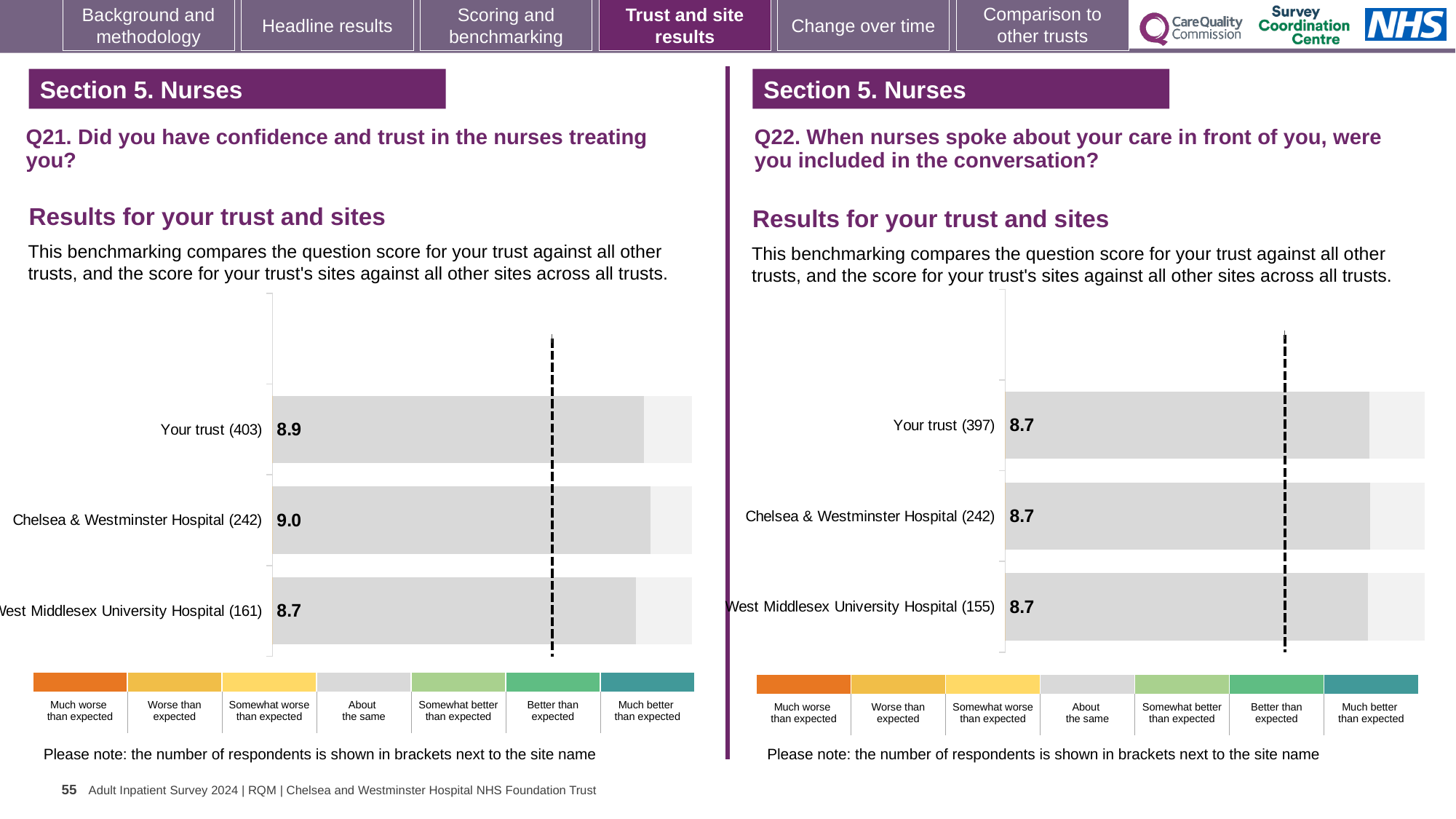
On the Q22 chart (right), how many bars are plotted? 3 On the Q22 chart (right), what is the score for Chelsea & Westminster Hospital? 8.7 On the Q21 chart (left), what is the score for Your trust? 8.9 On the Q21 chart (left), what is the score for Chelsea & Westminster Hospital? 9.0 On the Q21 chart (left), what is the score for West Middlesex University Hospital? 8.7 On the Q21 chart (left), what is the difference between the scores for Chelsea & Westminster Hospital and West Middlesex University Hospital? 0.3 On the Q22 chart (right), how many respondents are shown in brackets for West Middlesex University Hospital? 155 On the Q22 chart (right), what is the score for Your trust? 8.7 On the Q21 chart (left), which site or trust has the highest score? Chelsea & Westminster Hospital What type of chart is used on the Q21 chart (left)? Bar chart On the Q21 chart (left), which site or trust has the lowest score? West Middlesex University Hospital On the Q21 chart (left), which has the larger score, Your trust or West Middlesex University Hospital? Your trust